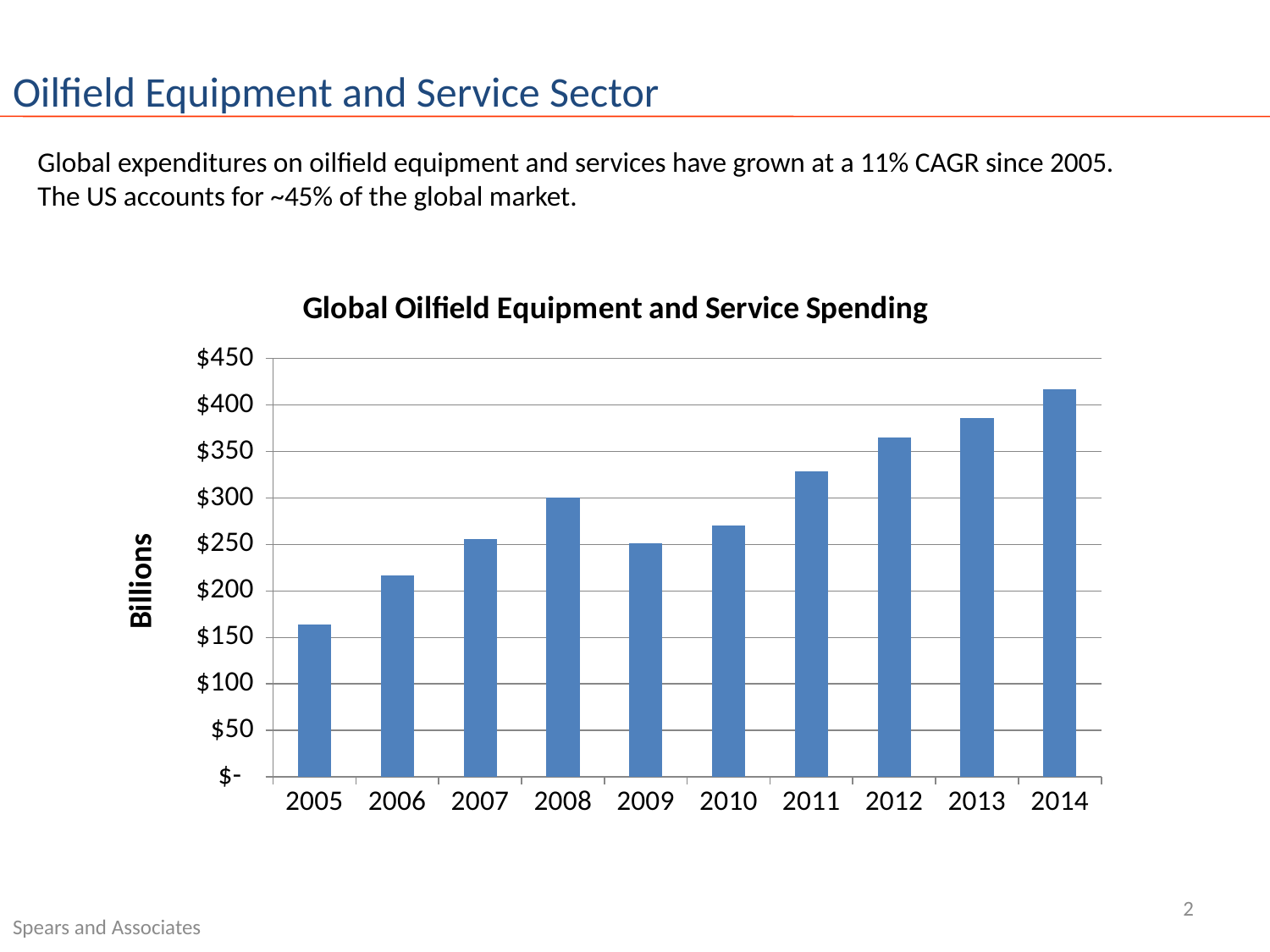
Is the value for 2005 greater or less than $150? greater Is the value for 2009 greater or less than $300? less What is the title of the chart? Global Oilfield Equipment and Service Spending Which year has the larger value, 2008 or 2009? 2008 Which year has the lowest spending in the chart? 2005 What type of chart is shown on the slide? Bar chart Is the value for 2014 greater or less than $400? greater Do the values generally rise or fall from 2005 to 2014? Rise How many years are shown on the x axis of the chart? 10 What is the label on the vertical axis of the chart? Billions Which year has the highest spending in the chart? 2014